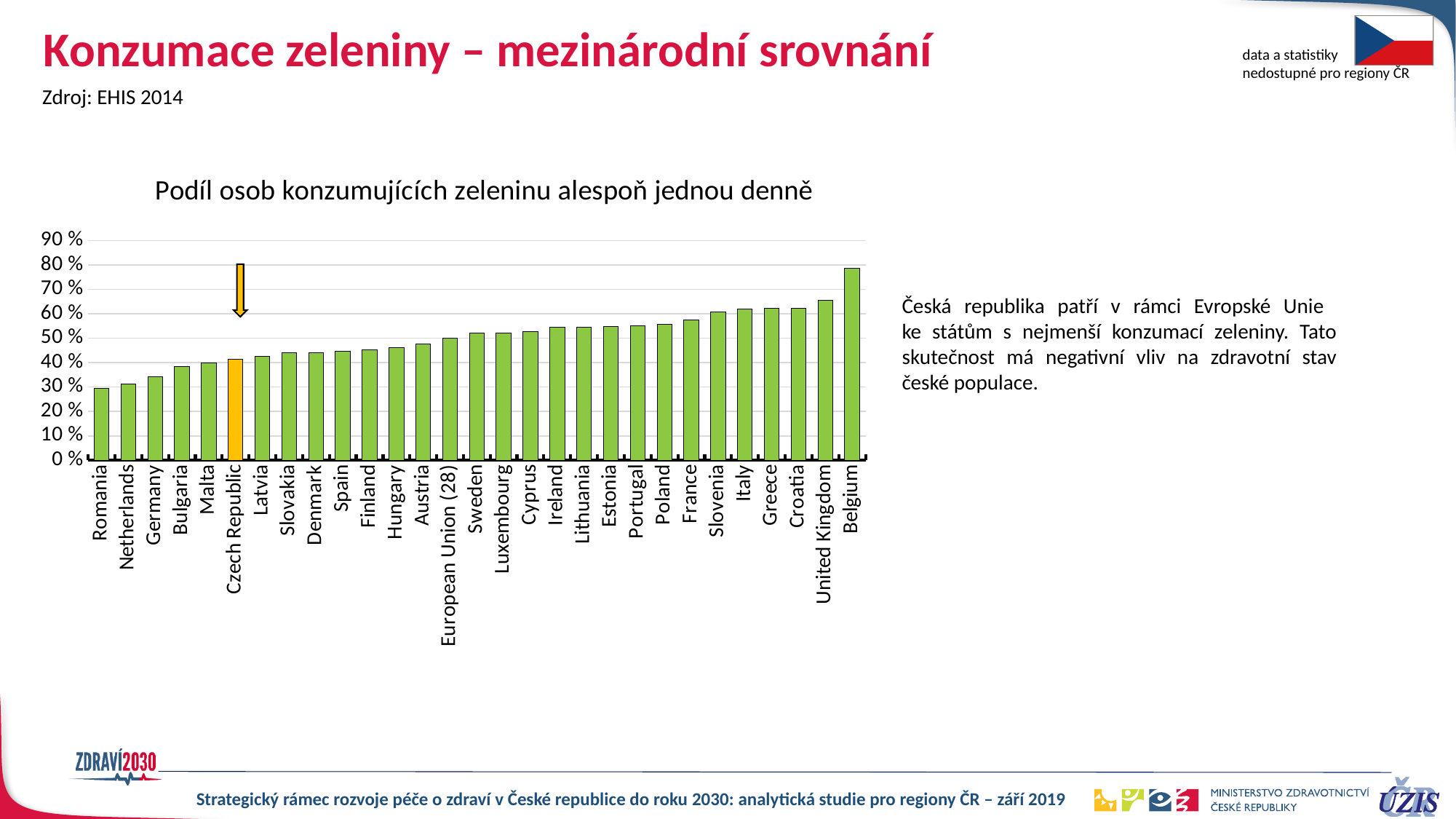
Is the value for Belgium greater or less than 70 %? greater Which is larger, the value for Czech Republic or the value for Italy? Italy Is the value for Germany greater or less than 40 %? less Which country has the lowest share of people consuming vegetables at least once a day? Romania Do the values rise or fall from left to right along the x axis? rise Which country has the highest share of people consuming vegetables at least once a day? Belgium What kind of chart is shown on the slide? bar chart Which country's bar is highlighted in a different colour (orange) from the others? Czech Republic How many categories (bars) are plotted in the chart? 29 Which is larger, the value for Netherlands or the value for France? France Is the value for Czech Republic greater or less than 50 %? less